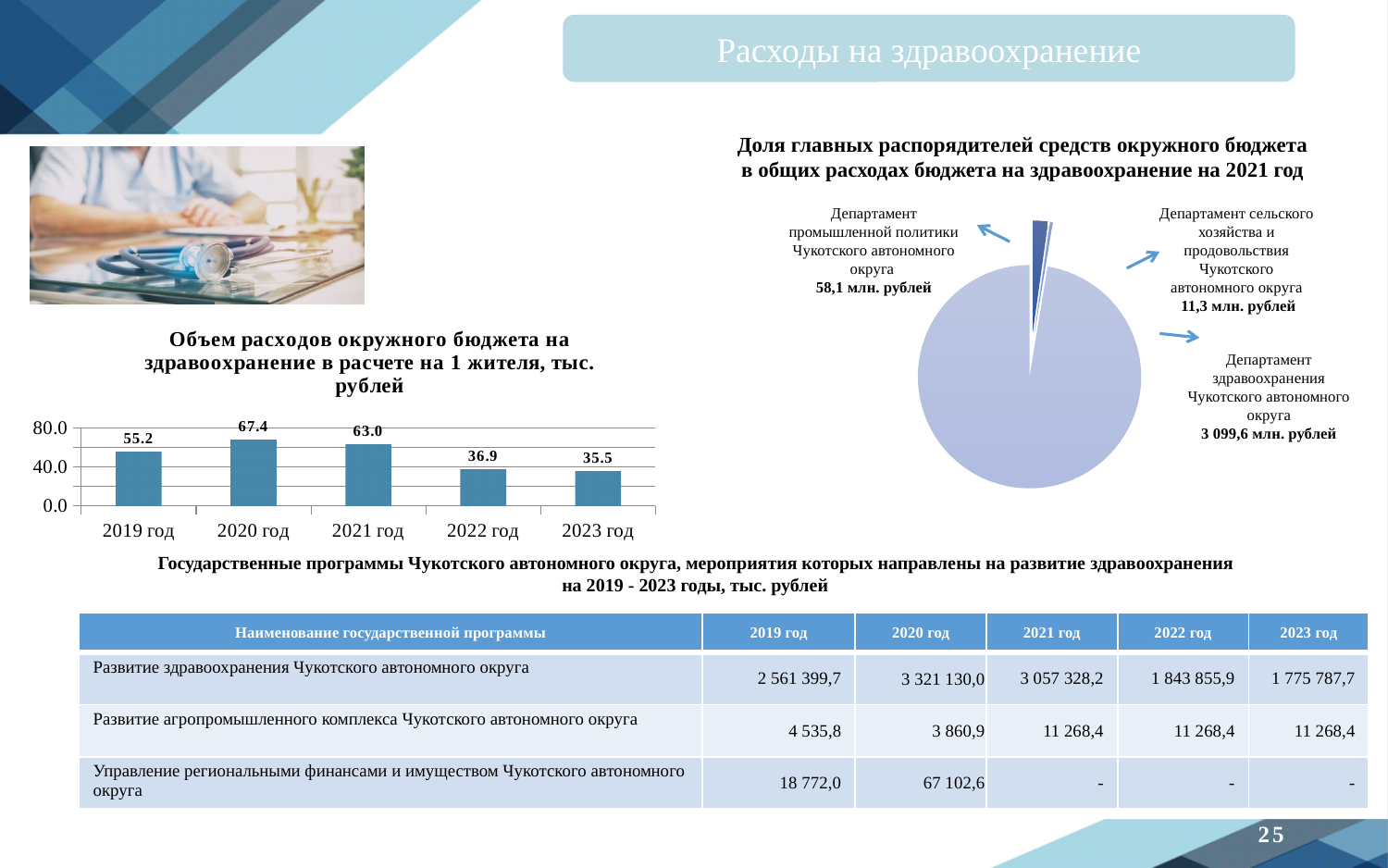
On the bar chart 'Объем расходов окружного бюджета на здравоохранение в расчете на 1 жителя, тыс. рублей', how many years are shown? 5 On the bar chart 'Объем расходов окружного бюджета на здравоохранение в расчете на 1 жителя, тыс. рублей', what is the difference between the values for 2020 год and 2021 год? 4.4 What kind of chart is 'Объем расходов окружного бюджета на здравоохранение в расчете на 1 жителя, тыс. рублей'? bar chart On the bar chart 'Объем расходов окружного бюджета на здравоохранение в расчете на 1 жителя, тыс. рублей', which year has the highest value? 2020 год On the pie chart 'Доля главных распорядителей средств окружного бюджета в общих расходах бюджета на здравоохранение на 2021 год', what is the value for Департамент здравоохранения Чукотского автономного округа? 3 099,6 млн. рублей On the bar chart 'Объем расходов окружного бюджета на здравоохранение в расчете на 1 жителя, тыс. рублей', which is larger: the value for 2019 год or 2022 год? 2019 год On the bar chart 'Объем расходов окружного бюджета на здравоохранение в расчете на 1 жителя, тыс. рублей', which year has the lowest value? 2023 год On the bar chart 'Объем расходов окружного бюджета на здравоохранение в расчете на 1 жителя, тыс. рублей', what is the value for 2023 год? 35.5 On the bar chart 'Объем расходов окружного бюджета на здравоохранение в расчете на 1 жителя, тыс. рублей', do the values rise or fall from 2021 год to 2023 год? fall On the bar chart 'Объем расходов окружного бюджета на здравоохранение в расчете на 1 жителя, тыс. рублей', is the value for 2021 год greater or less than 40.0? greater On the bar chart 'Объем расходов окружного бюджета на здравоохранение в расчете на 1 жителя, тыс. рублей', what is the value for 2020 год? 67.4